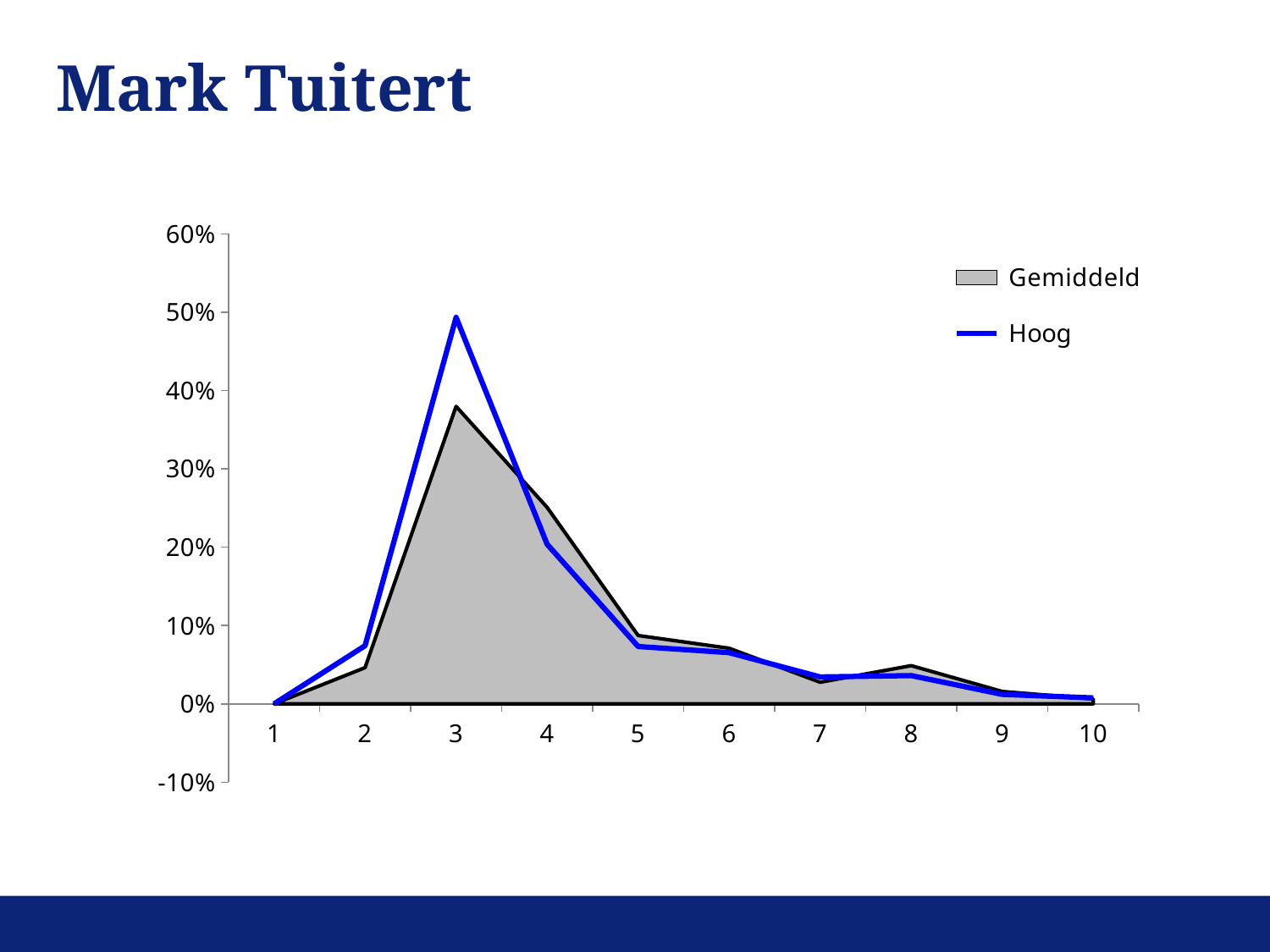
How many series does the legend list? 2 At x = 4, which series has the larger value, Gemiddeld or Hoog? Gemiddeld Is the value of Hoog at 3 greater or less than 40%? greater At which x-axis value does the Gemiddeld series reach its highest point? 3 Do the values of the Hoog series rise or fall from x = 3 to x = 10? fall How many points are plotted along the x axis? 10 Is the value of Hoog at 4 greater or less than 30%? less What colour is the Hoog series line? blue What are the two series named in the legend? Gemiddeld and Hoog Is the value of Gemiddeld at 3 greater or less than 40%? less At which x-axis value does the Hoog series reach its highest point? 3 At x = 3, which series has the larger value, Gemiddeld or Hoog? Hoog